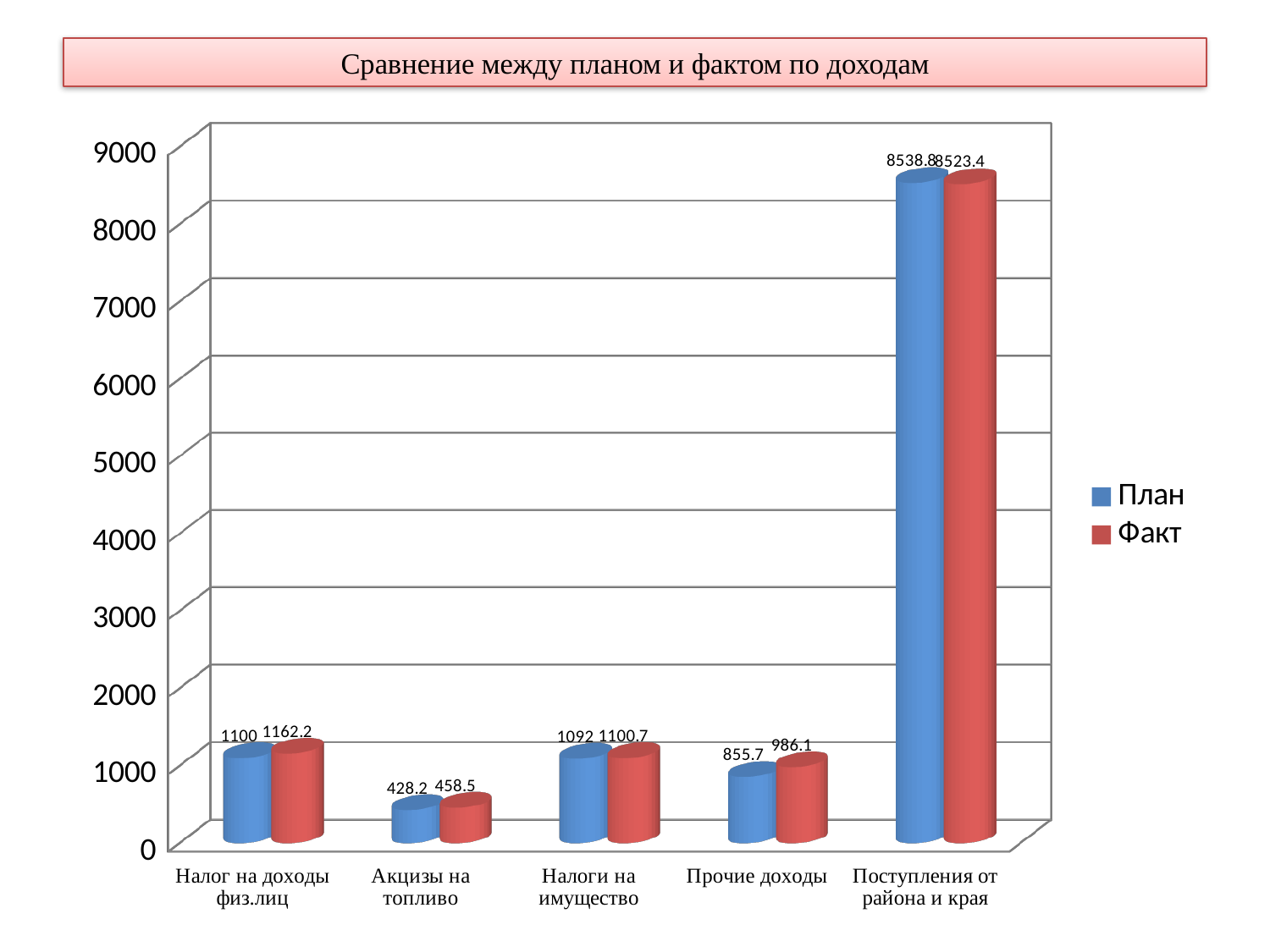
How many series does the legend list? 2 For Прочие доходы, which is larger: План or Факт? Факт What kind of chart is shown on the slide? Bar chart Which category has the lowest Факт value? Акцизы на топливо What is the difference between the Факт and План values for Налог на доходы физ.лиц? 62.2 How many categories are shown on the x axis? 5 Is the Факт value for Налоги на имущество greater or less than 1000? greater What is the Факт value for Акцизы на топливо? 458.5 What is the План value for Прочие доходы? 855.7 What is the План value for Налоги на имущество? 1092 Which category has the highest План value? Поступления от района и края What is the title of the chart? Сравнение между планом и фактом по доходам